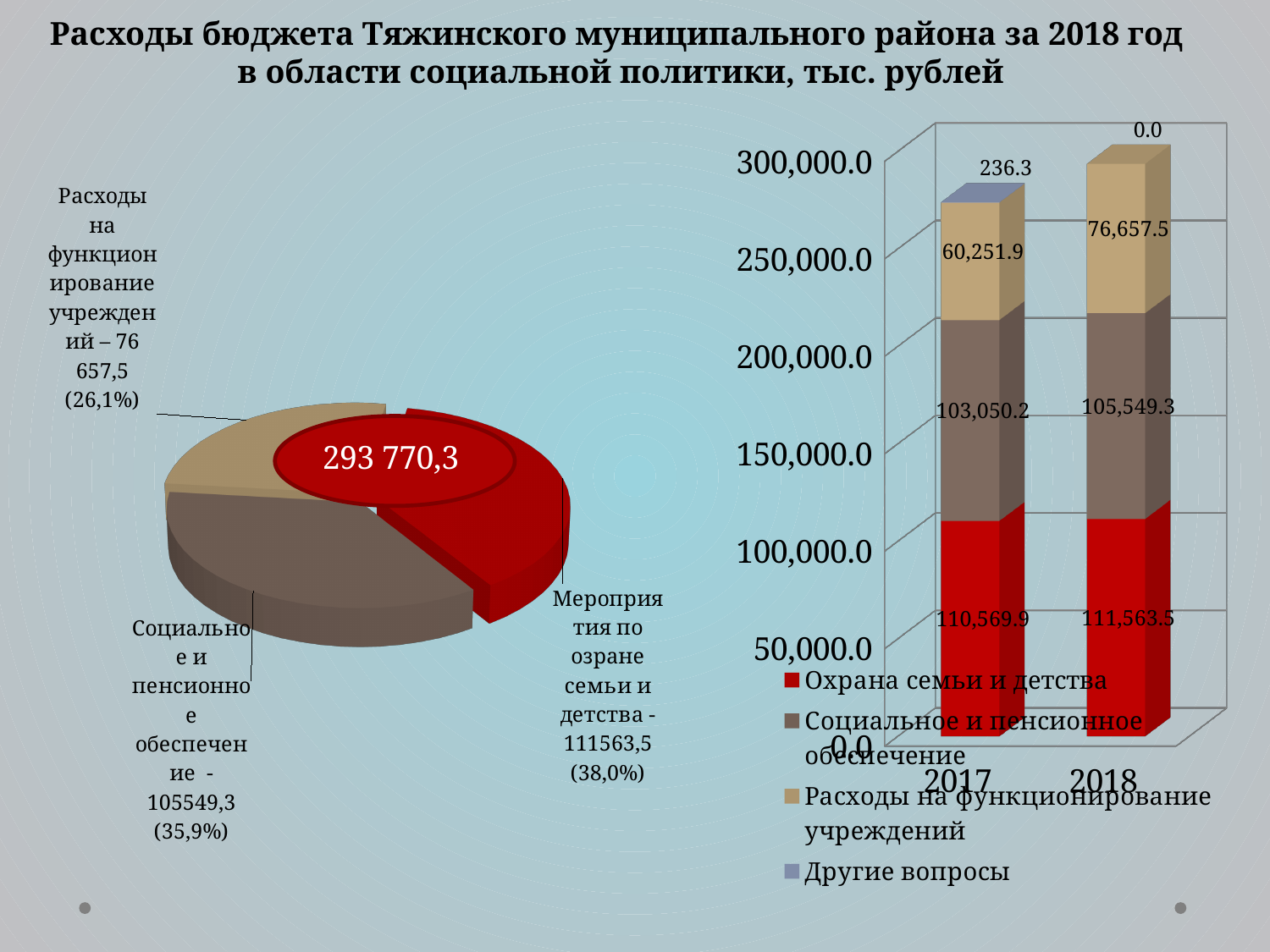
In the bar chart on the right, which year has the larger value for Социальное и пенсионное обеспечение, 2017 or 2018? 2018 In the pie chart on the left, what total value is printed in the centre of the pie? 293 770,3 In the bar chart on the right, what is the total of the stacked bar for 2017? 274,108.3 What type of chart is the chart on the right of the slide? bar chart In the bar chart on the right, how many series does the legend list? 4 In the bar chart on the right, what is the value for Охрана семьи и детства in 2017? 110,569.9 In the pie chart on the left, what value is shown for Социальное и пенсионное обеспечение? 105549,3 In the pie chart on the left, which slice has the smallest share? Расходы на функционирование учреждений In the bar chart on the right, what is the difference between the Расходы на функционирование учреждений values for 2018 and 2017? 16,405.6 What type of chart is the chart on the left of the slide? pie chart In the bar chart on the right, what is the value for Расходы на функционирование учреждений in 2018? 76,657.5 In the pie chart on the left, what share is shown for Мероприятия по охране семьи и детства? 38,0%